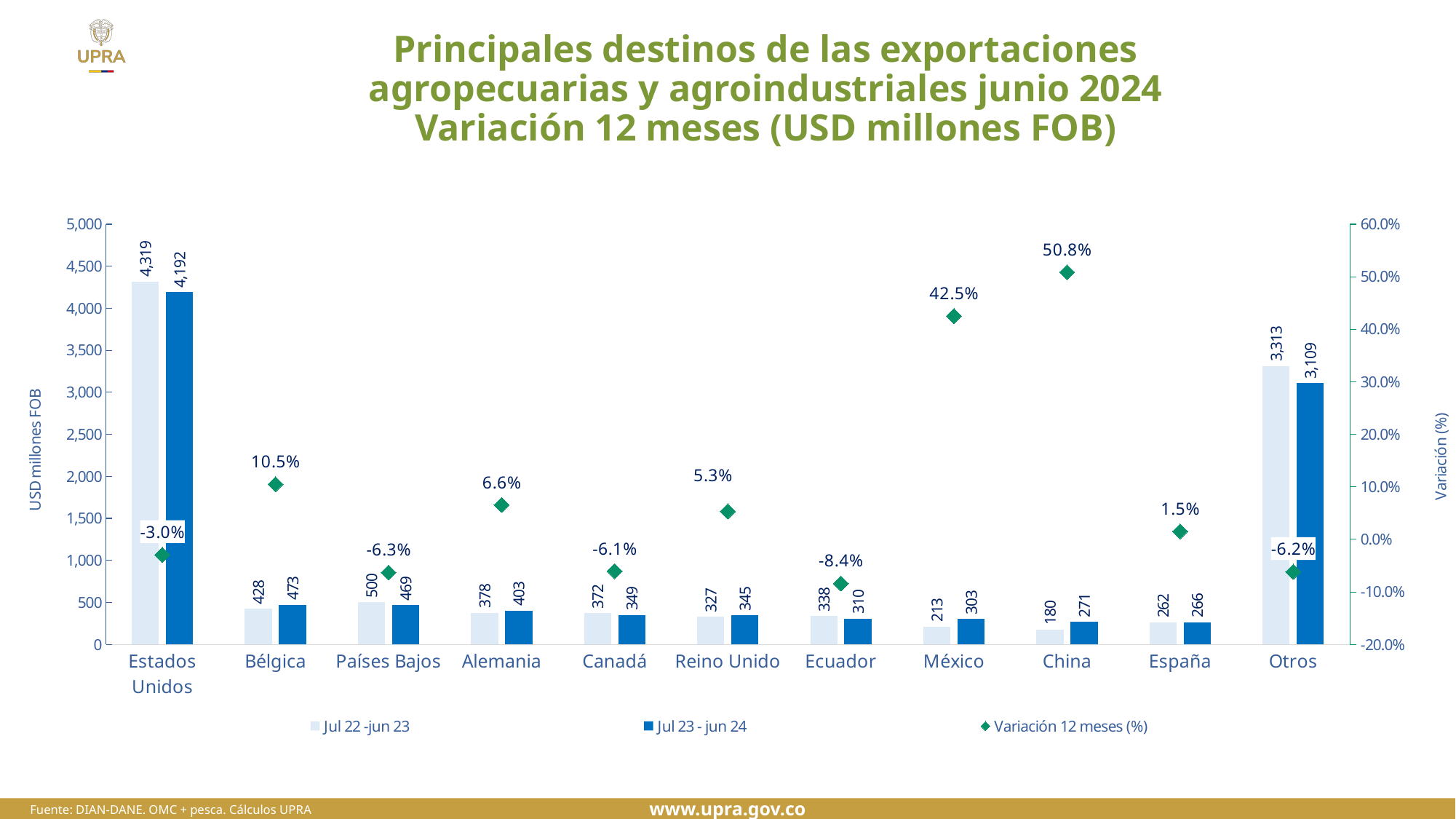
What is the Variación 12 meses (%) value for China? 50.8% How many categories are shown on the x axis? 11 Is the Jul 23 - jun 24 value for Otros greater or less than 3,000? greater Which is larger for México: the Jul 22 -jun 23 value or the Jul 23 - jun 24 value? Jul 23 - jun 24 How many series does the legend list? 3 What is the value for Países Bajos in the Jul 22 -jun 23 series? 500 What kind of chart is used for the Jul 22 -jun 23 and Jul 23 - jun 24 series? Bar chart Which category has the lowest value in the Jul 22 -jun 23 series? China What is the Variación 12 meses (%) value for Ecuador? -8.4% What is the value for Estados Unidos in the Jul 23 - jun 24 series? 4,192 Which country has the highest Variación 12 meses (%)? China What is the difference between the Jul 22 -jun 23 and Jul 23 - jun 24 values for Estados Unidos? 127